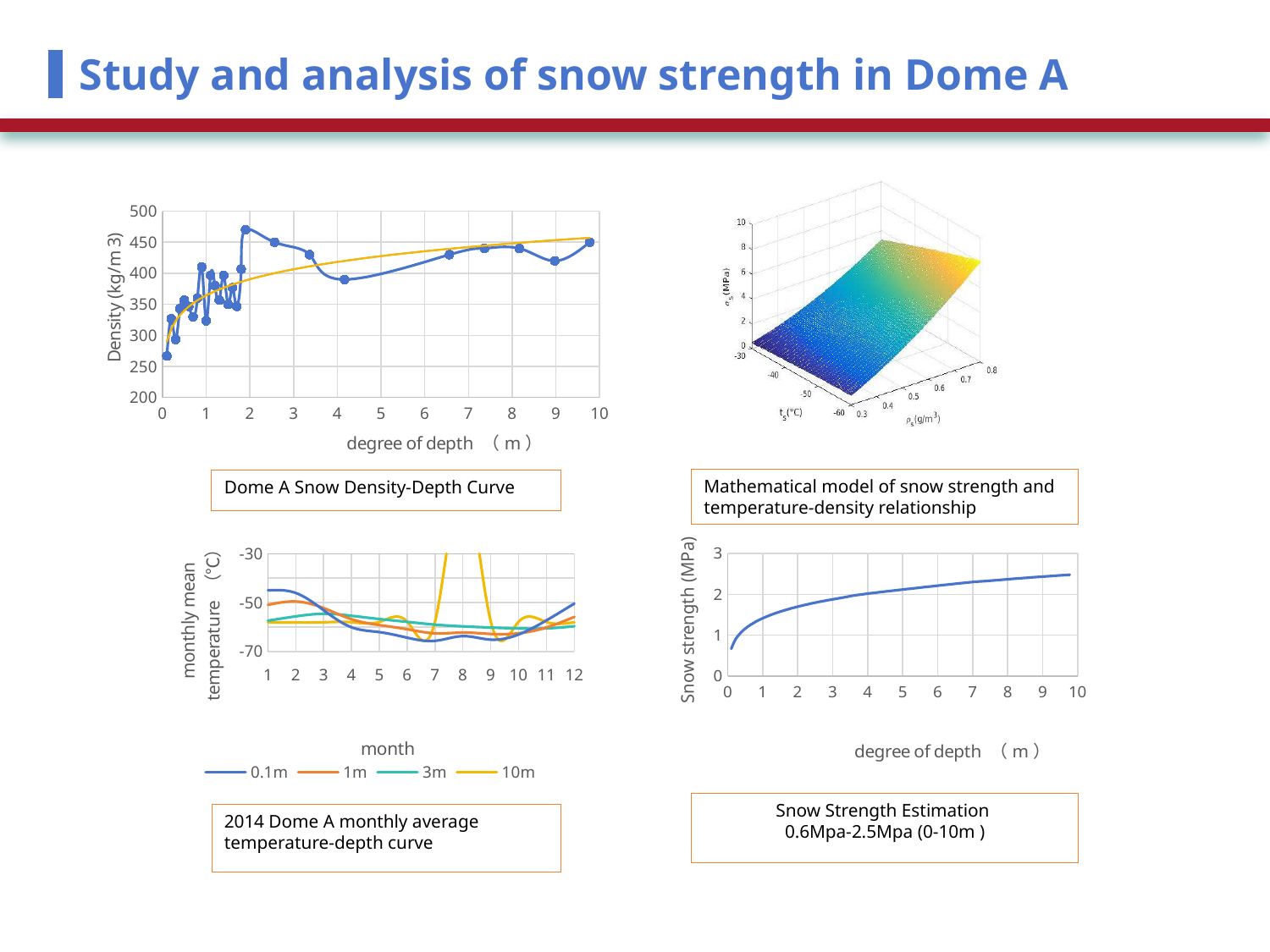
In the Snow Strength Estimation chart, is the snow strength at a depth of 1 m greater or less than 1? greater In the Snow Strength Estimation chart, is the snow strength at a depth of 9 m greater or less than 2? greater How many months are shown on the x axis of the 2014 Dome A monthly average temperature-depth curve chart? 12 In the Snow Strength Estimation chart, do the values rise or fall as the degree of depth increases? rise How many series does the legend of the 2014 Dome A monthly average temperature-depth curve chart list? 4 In the 2014 Dome A monthly average temperature-depth curve chart, is the 0.1m series value in month 7 greater or less than -60? less In the Dome A Snow Density-Depth Curve, does the density overall rise or fall as depth increases from 0 to 10 m? rise What kind of chart is the Dome A Snow Density-Depth Curve? line chart What are the legend entries of the 2014 Dome A monthly average temperature-depth curve chart? 0.1m, 1m, 3m, 10m